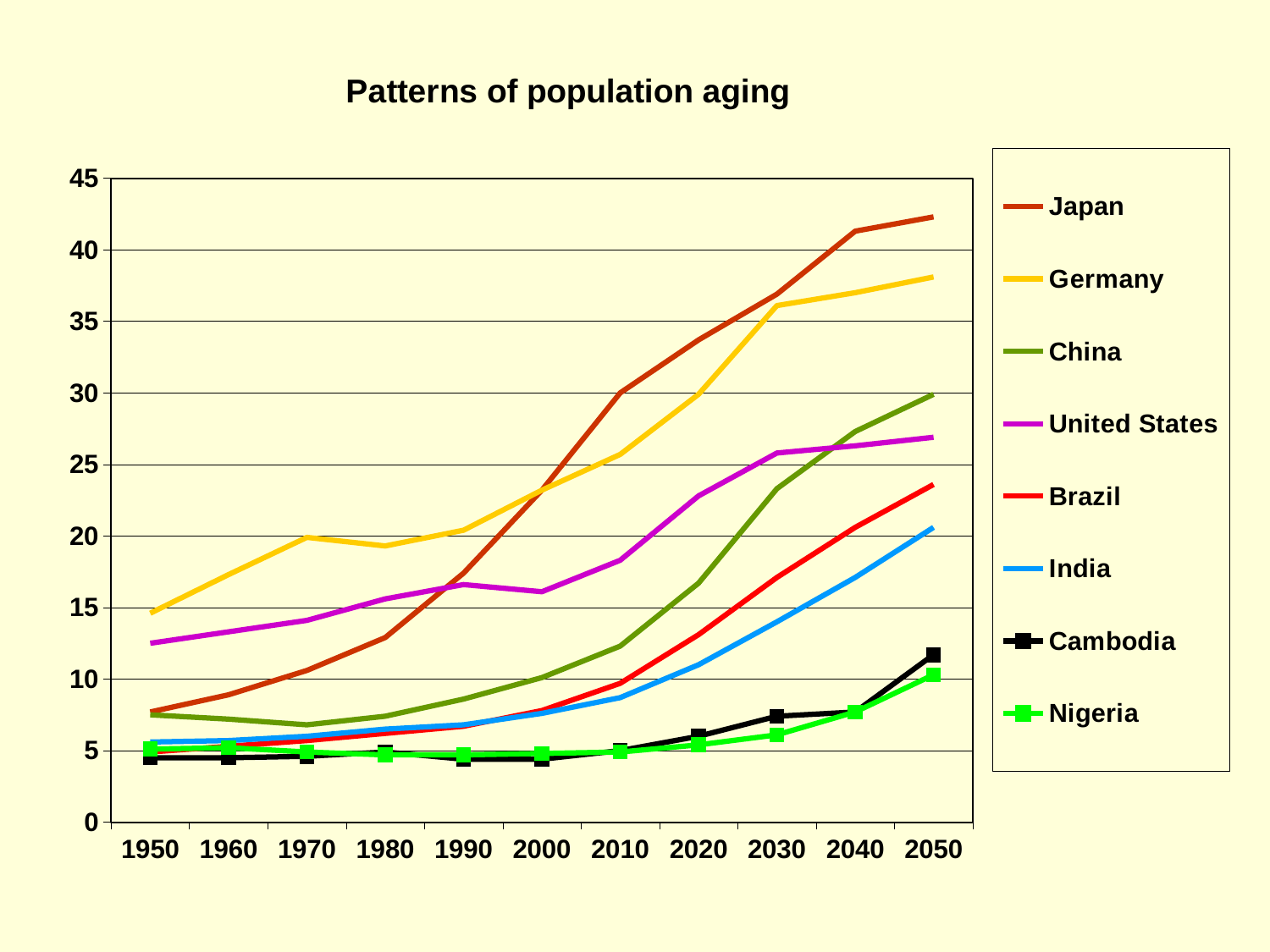
Which country has the highest value in 2050? Japan What is the title of the chart? Patterns of population aging Is the value for Japan in 2050 greater or less than 40? greater Which is larger in 2020, the value for the United States or the value for China? United States How many series does the legend list? 8 Does the value for Japan rise or fall from 1950 to 2050? rise Which country has the highest value in 1950? Germany How many years are shown along the x axis? 11 Is the value for China in 2050 greater or less than 25? greater Is the value for Brazil in 2050 greater or less than 25? less What kind of chart is shown on the slide? line chart Which country has the lowest value in 2050? Nigeria